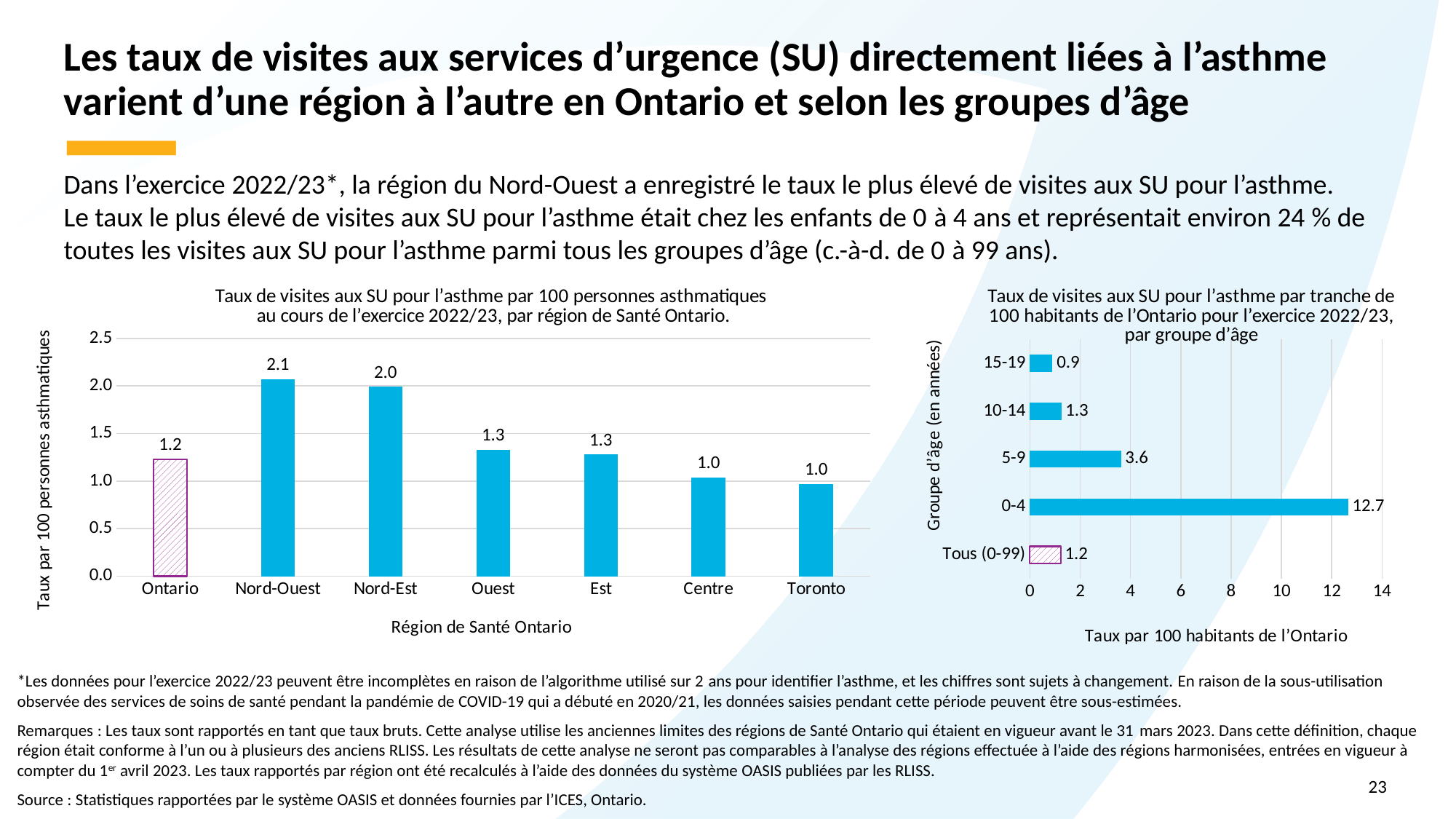
In the right chart (by groupe d'âge), what is the rate for the 5-9 age group? 3.6 In the right chart (by groupe d'âge), which age group has the highest rate? 0-4 In the left chart (by région de Santé Ontario), what is the rate for Ontario overall? 1.2 In the right chart (by groupe d'âge), which is larger: the rate for 5-9 or the rate for 15-19? 5-9 In the left chart (by région de Santé Ontario), what is the difference between the rates for Nord-Ouest and Centre? 1.1 In the left chart (by région de Santé Ontario), what is the rate for Nord-Ouest? 2.1 What kind of chart is the left chart (by région de Santé Ontario)? Bar chart In the right chart (by groupe d'âge), what is the difference between the rates for 0-4 and 10-14? 11.4 In the left chart (by région de Santé Ontario), how many regions (categories) are shown on the x axis? 7 In the left chart (by région de Santé Ontario), is the value for Nord-Est greater or less than 1.5? greater In the right chart (by groupe d'âge), which age group has the lowest rate? 15-19 In the left chart (by région de Santé Ontario), what is the rate for Toronto? 1.0